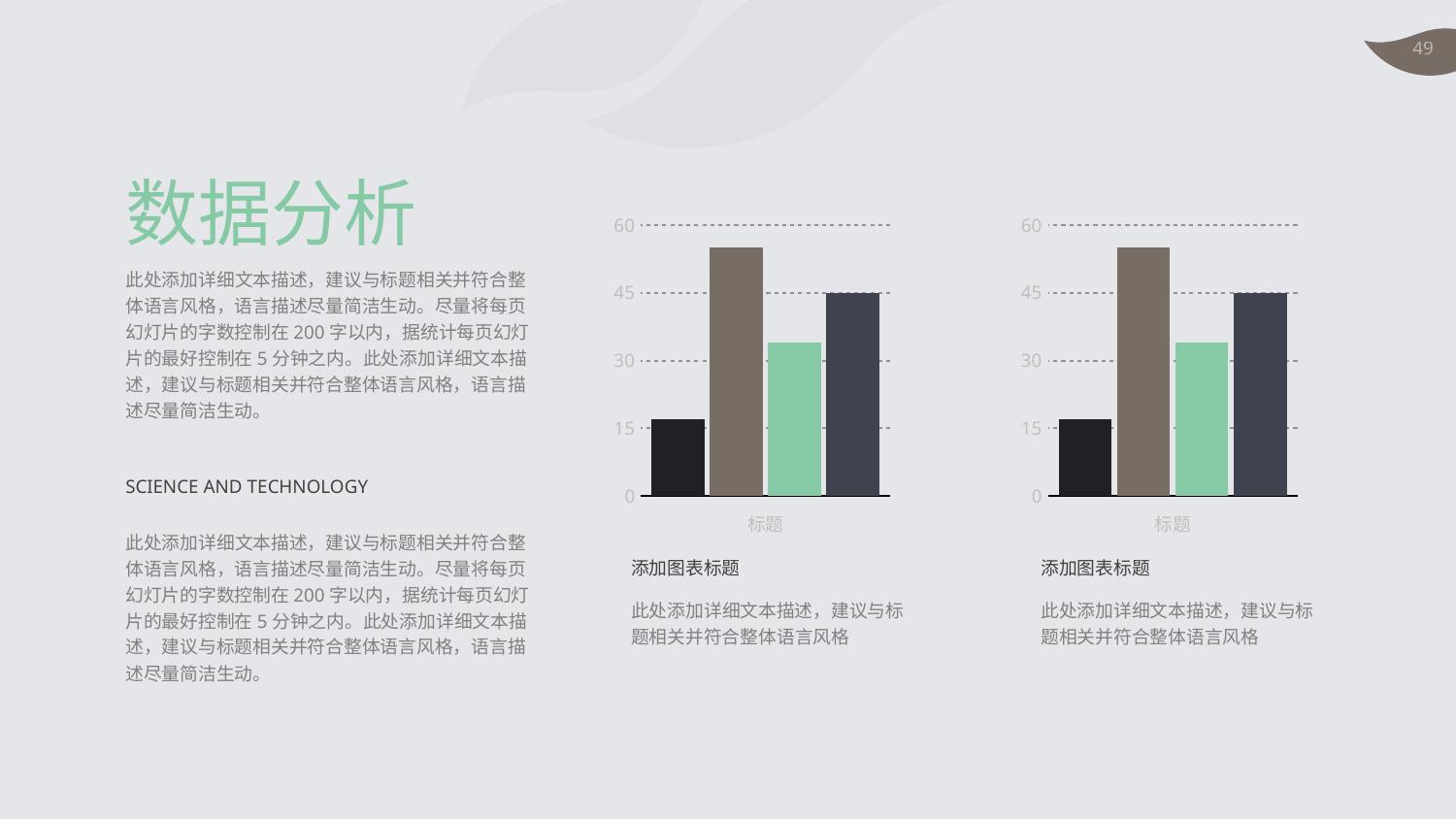
In the left chart, which bar is the tallest? the brown bar (second from left) How many categories are shown on the x axis of the left chart? 1 In the right chart, which bar is the tallest? the brown bar (second from left) In the left chart, is the value of the black bar greater or less than 30? less In the right chart, is the value of the green bar greater or less than 45? less In the left chart, which bar is the shortest? the black bar (first from left) What is the highest value shown on the y axis of the left chart? 60 How many bars are plotted in the left chart? 4 What is the category label on the x axis of the right chart? 标题 In the right chart, which is larger, the green bar or the dark slate bar on the far right? the dark slate bar What kind of chart is the left chart on the slide? bar chart In the left chart, is the value of the brown bar greater or less than 45? greater